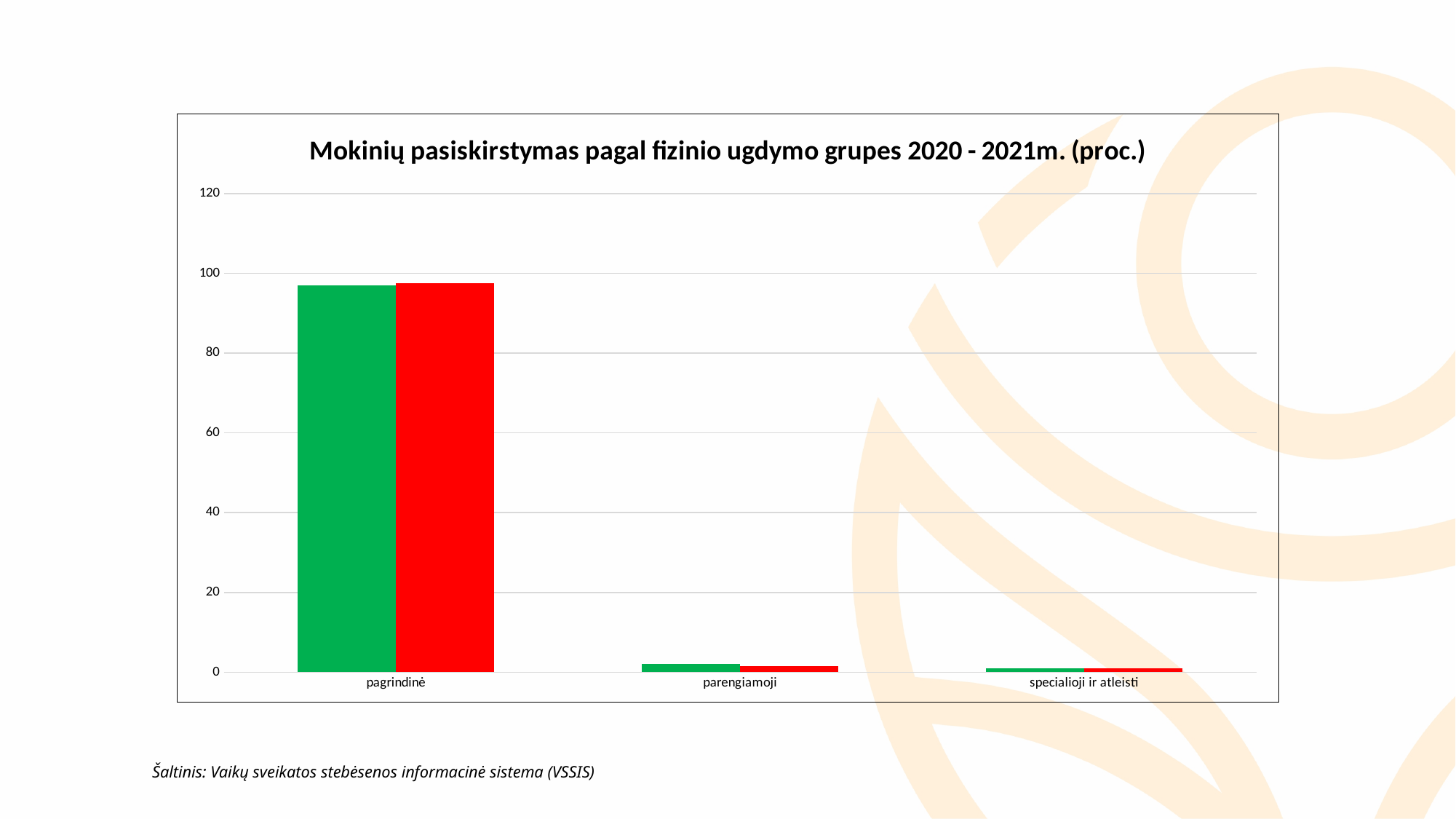
Which category has the highest values in the chart? pagrindinė Is the value of the green bar for parengiamoji greater or less than 20? less Which is larger, the green bar for pagrindinė or the green bar for parengiamoji? pagrindinė What two colours are used for the bars in the chart? green and red Is the value of the red bar for specialioji ir atleisti greater or less than 20? less How many categories are shown on the x axis of the chart? 3 Is the value of the red bar for pagrindinė greater or less than 100? less Which category has the lowest values in the chart? specialioji ir atleisti What kind of chart is shown on the slide? bar chart What is the title of the chart? Mokinių pasiskirstymas pagal fizinio ugdymo grupes 2020 - 2021m. (proc.) Do the values rise or fall moving from left to right along the x axis? fall